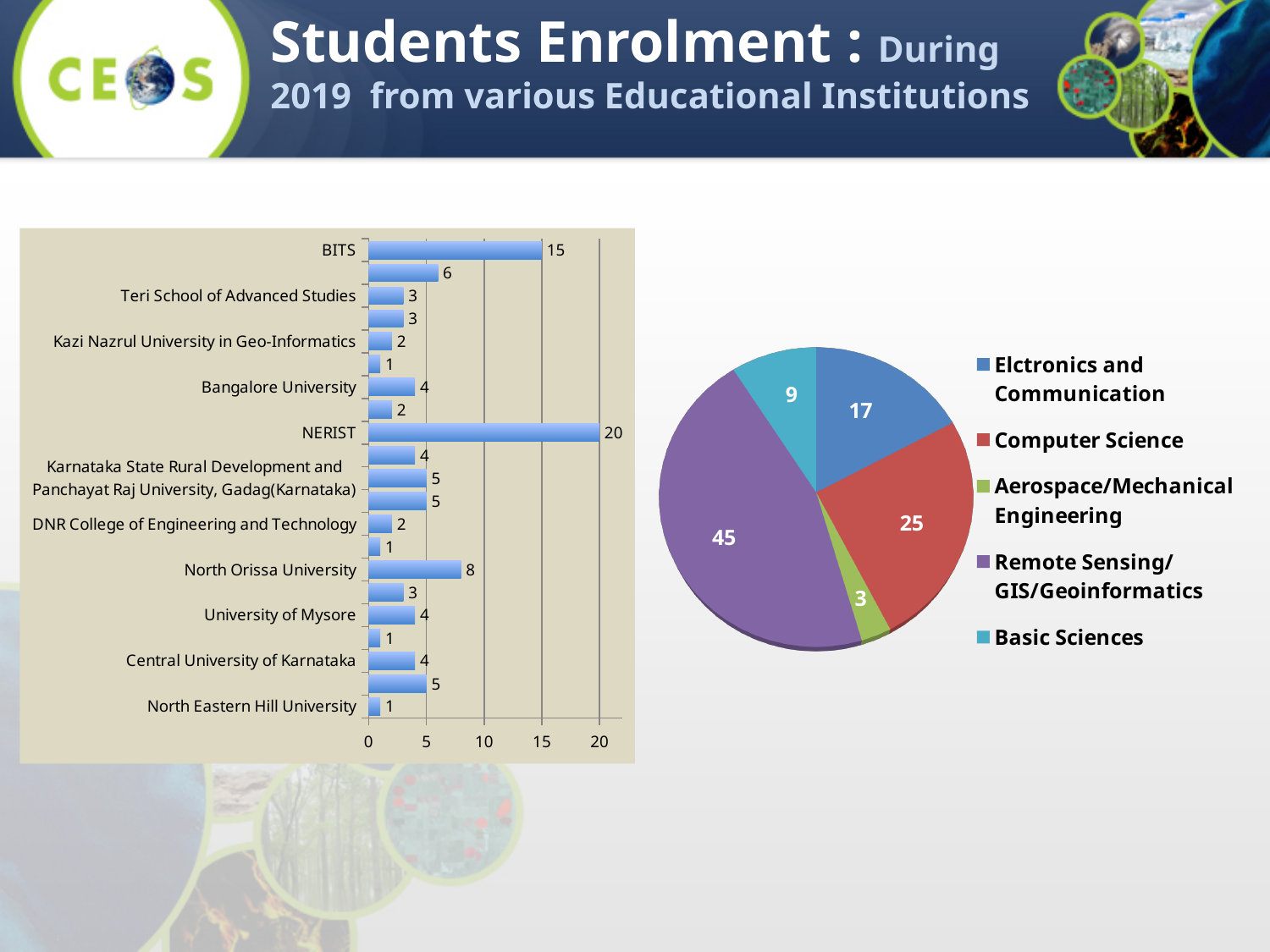
In the bar chart on the left, what is the value for North Orissa University? 8 What type of chart is shown on the left of the slide? Bar chart In the bar chart on the left, how many bars are plotted? 21 In the bar chart on the left, which has a larger value: North Orissa University or University of Mysore? North Orissa University In the bar chart on the left, what is the difference between the values for NERIST and BITS? 5 In the bar chart on the left, which institution has the highest value? NERIST In the bar chart on the left, what is the value for NERIST? 20 In the bar chart on the left, what is the value for BITS? 15 In the pie chart on the right, what is the value for Computer Science? 25 In the pie chart on the right, which category has the smallest slice? Aerospace/Mechanical Engineering How many categories does the legend of the pie chart on the right list? 5 In the pie chart on the right, which category has the largest slice? Remote Sensing/ GIS/Geoinformatics